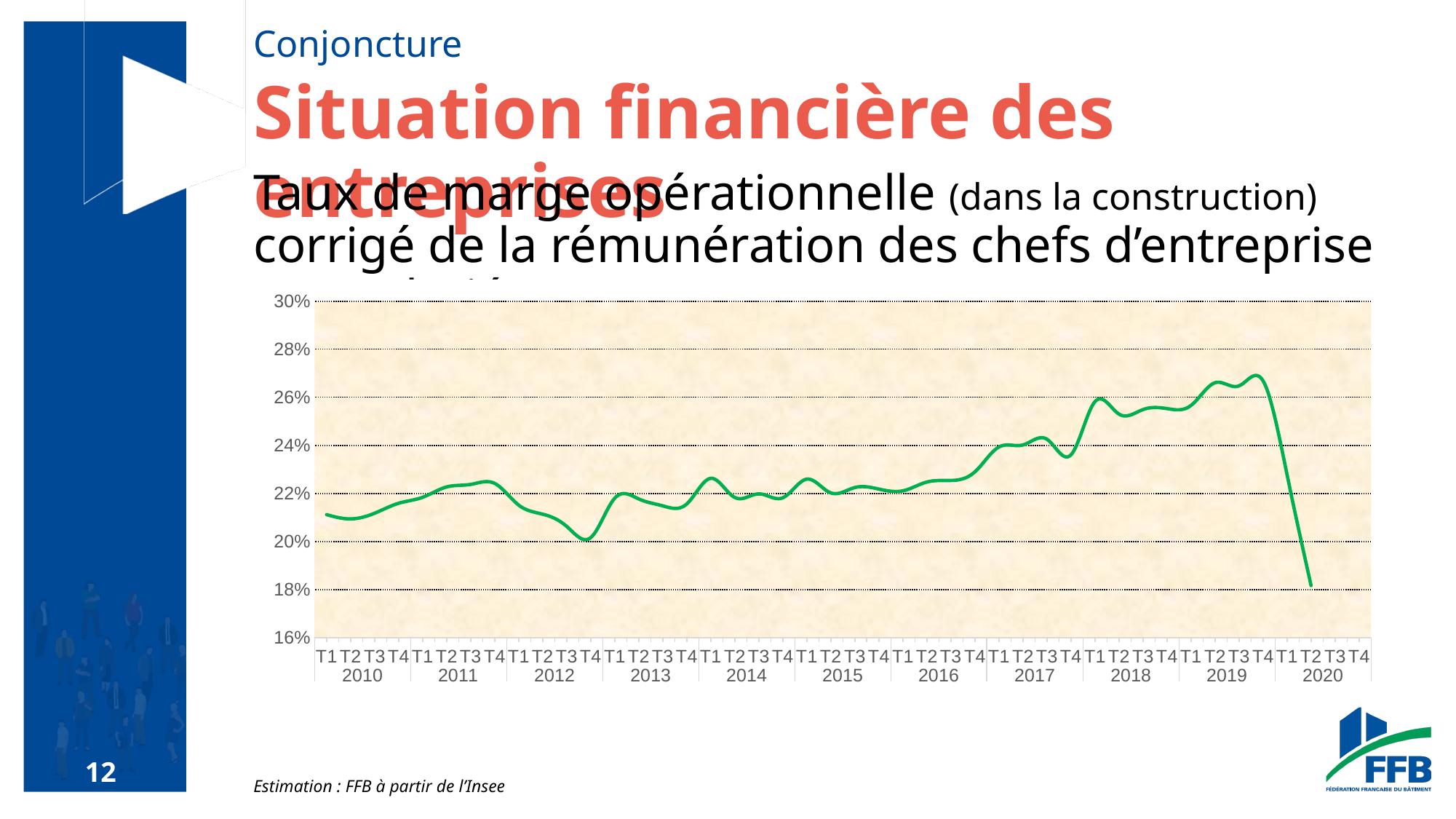
Is the value for T1 2012 greater or less than 22%? less Is the value for T4 2019 greater or less than 26%? greater How many years are labelled on the x axis? 11 What kind of chart is shown on the slide? line chart What colour is the line plotted on the chart? green Which is larger, the value for T4 2019 or the value for T2 2020? T4 2019 Is the value for T3 2017 greater or less than 24%? greater Does the line rise or fall between T4 2019 and T2 2020? fall Which quarter has the lowest value on the chart? T2 2020